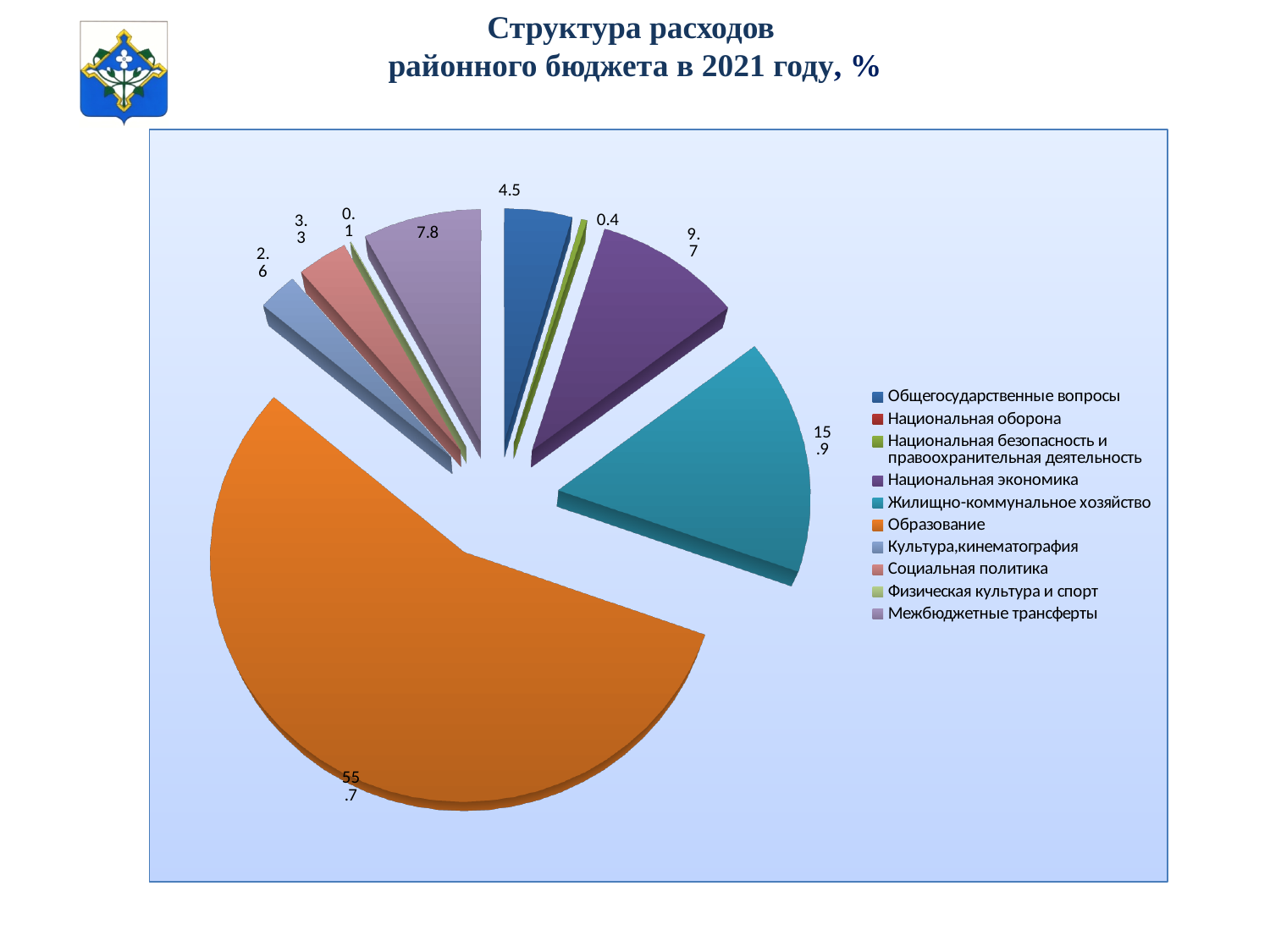
What is the value for Национальная экономика? 9.7 What is the difference between the values for Жилищно-коммунальное хозяйство and Национальная экономика? 6.2 What is the value for Образование? 55.7 What is the value for Межбюджетные трансферты? 7.8 What is the title of the chart? Структура расходов районного бюджета в 2021 году, % What colour is the slice for Образование? orange What is the value for Жилищно-коммунальное хозяйство? 15.9 How many entries does the legend list? 10 What kind of chart is shown on the slide? pie chart Which is larger, Социальная политика or Культура,кинематография? Социальная политика What is the value for Общегосударственные вопросы? 4.5 Which category has the largest share of the pie? Образование